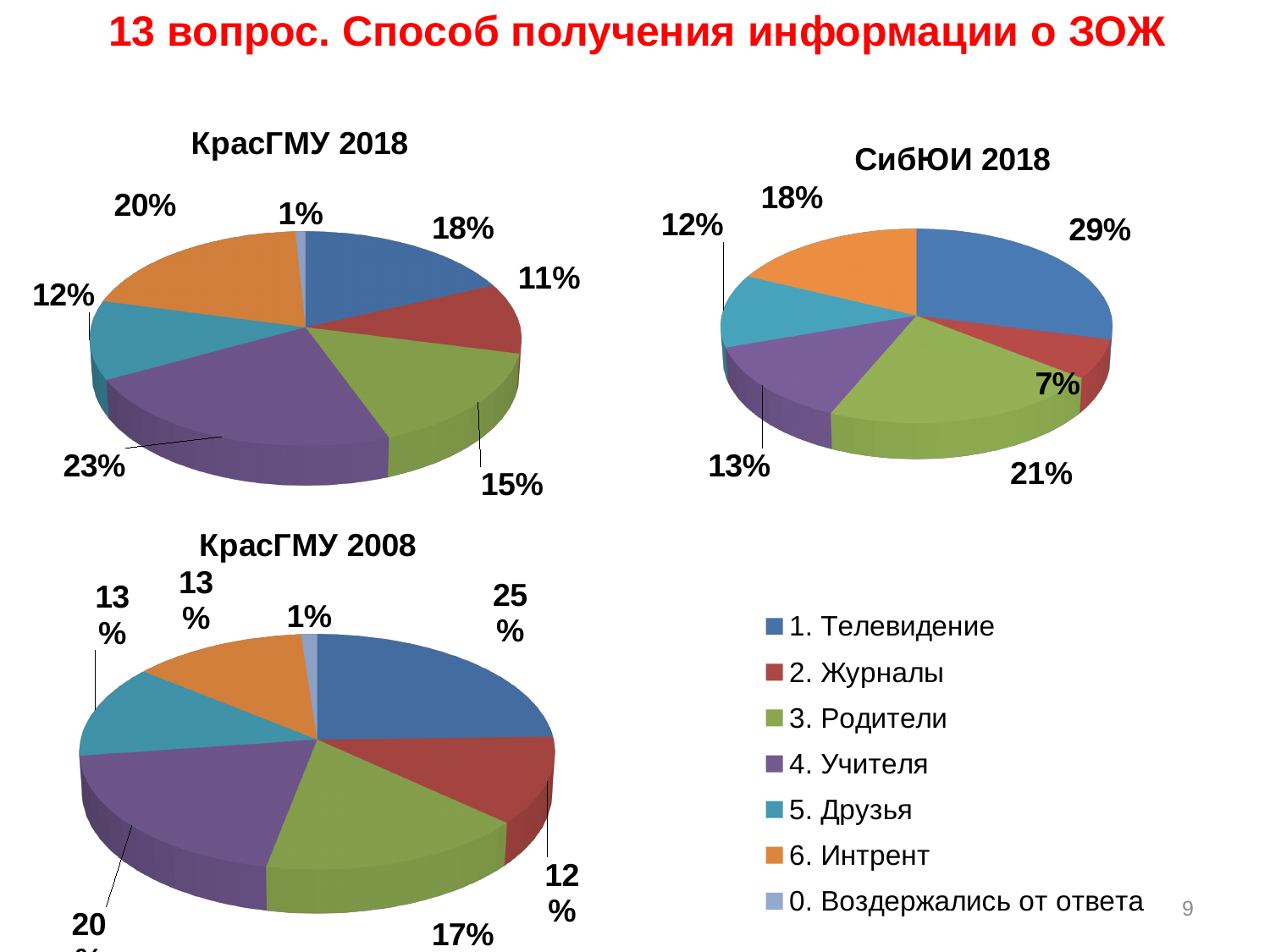
What kind of chart is КрасГМУ 2008? Pie chart In the КрасГМУ 2008 chart, what share is Воздержались от ответа? 1% In the СибЮИ 2018 chart, which is larger: the share for Родители or the share for Интрент? Родители In the КрасГМУ 2018 chart, which category has the largest share? 4. Учителя How many entries does the legend list? 7 In the КрасГМУ 2018 chart, what share is Учителя? 23% In the СибЮИ 2018 chart, which category has the smallest share? 2. Журналы In the КрасГМУ 2008 chart, which category has the largest share? 1. Телевидение In the КрасГМУ 2018 chart, what is the difference between the shares for Интрент and Журналы? 9% In the СибЮИ 2018 chart, what share is Телевидение? 29% How many slices does the СибЮИ 2018 chart have? 6 In the КрасГМУ 2008 chart, what share is Родители? 17%